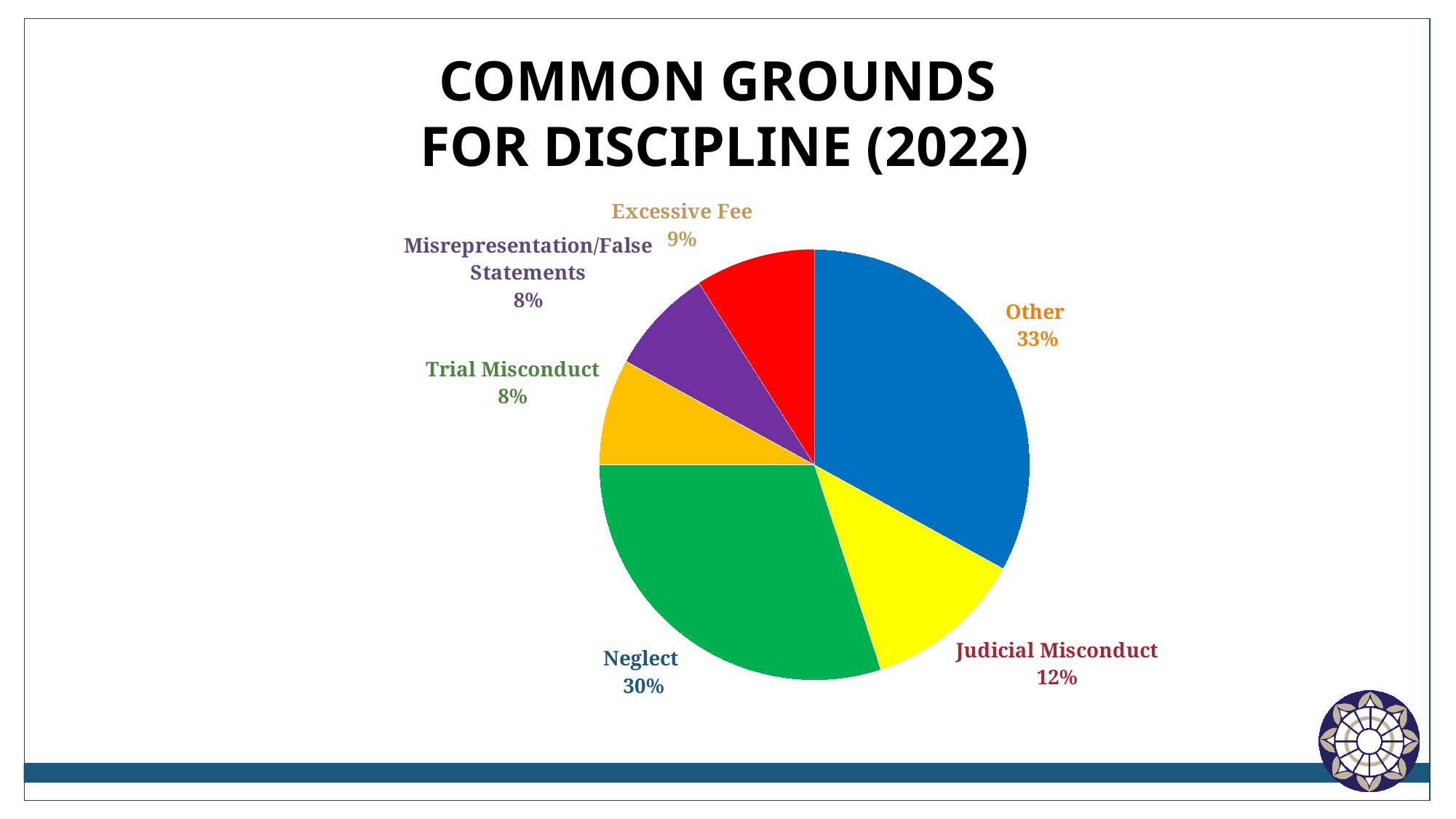
What is the title of the chart? COMMON GROUNDS FOR DISCIPLINE (2022) What percentage is shown for Misrepresentation/False Statements? 8% How many categories are shown in the pie chart? 6 Which category has the largest share of the pie? Other What colour is the Neglect slice? Green What kind of chart is shown on the slide? Pie chart What percentage is shown for Judicial Misconduct? 12% What percentage is shown for Excessive Fee? 9% What percentage of the pie is Neglect? 30% What is the difference in percentage points between Other and Neglect? 3 What is the difference in percentage points between Neglect and Judicial Misconduct? 18 Which is larger, Judicial Misconduct or Excessive Fee? Judicial Misconduct